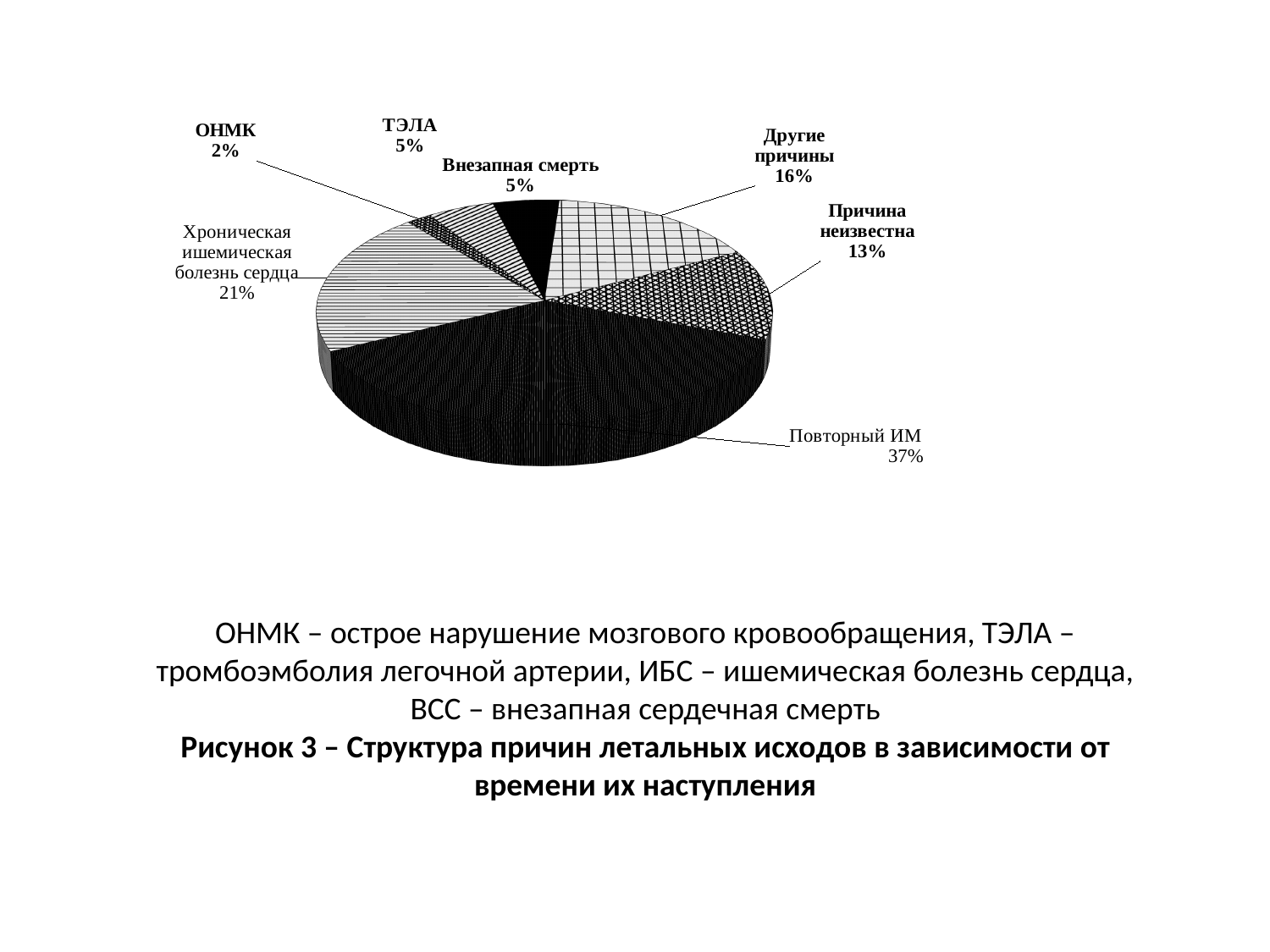
Какого типа диаграмма показана на слайде? Круговая диаграмма Какую долю занимает сектор «Хроническая ишемическая болезнь сердца»? 21% Какую долю занимает сектор «Повторный ИМ» на круговой диаграмме? 37% На сколько процентных пунктов доля «Повторный ИМ» больше доли «Хроническая ишемическая болезнь сердца»? 16 Какая причина летального исхода имеет наименьшую долю на диаграмме? ОНМК Какую долю занимает сектор «Другие причины»? 16% Какая причина летального исхода имеет наибольшую долю на диаграмме? Повторный ИМ Какую долю занимает сектор «ОНМК»? 2% Какие две категории имеют одинаковую долю 5%? ТЭЛА и Внезапная смерть Сколько секторов (категорий) показано на круговой диаграмме? 7 Какую долю занимает сектор «Причина неизвестна»? 13% Что больше: доля «Другие причины» или доля «Причина неизвестна»? Другие причины